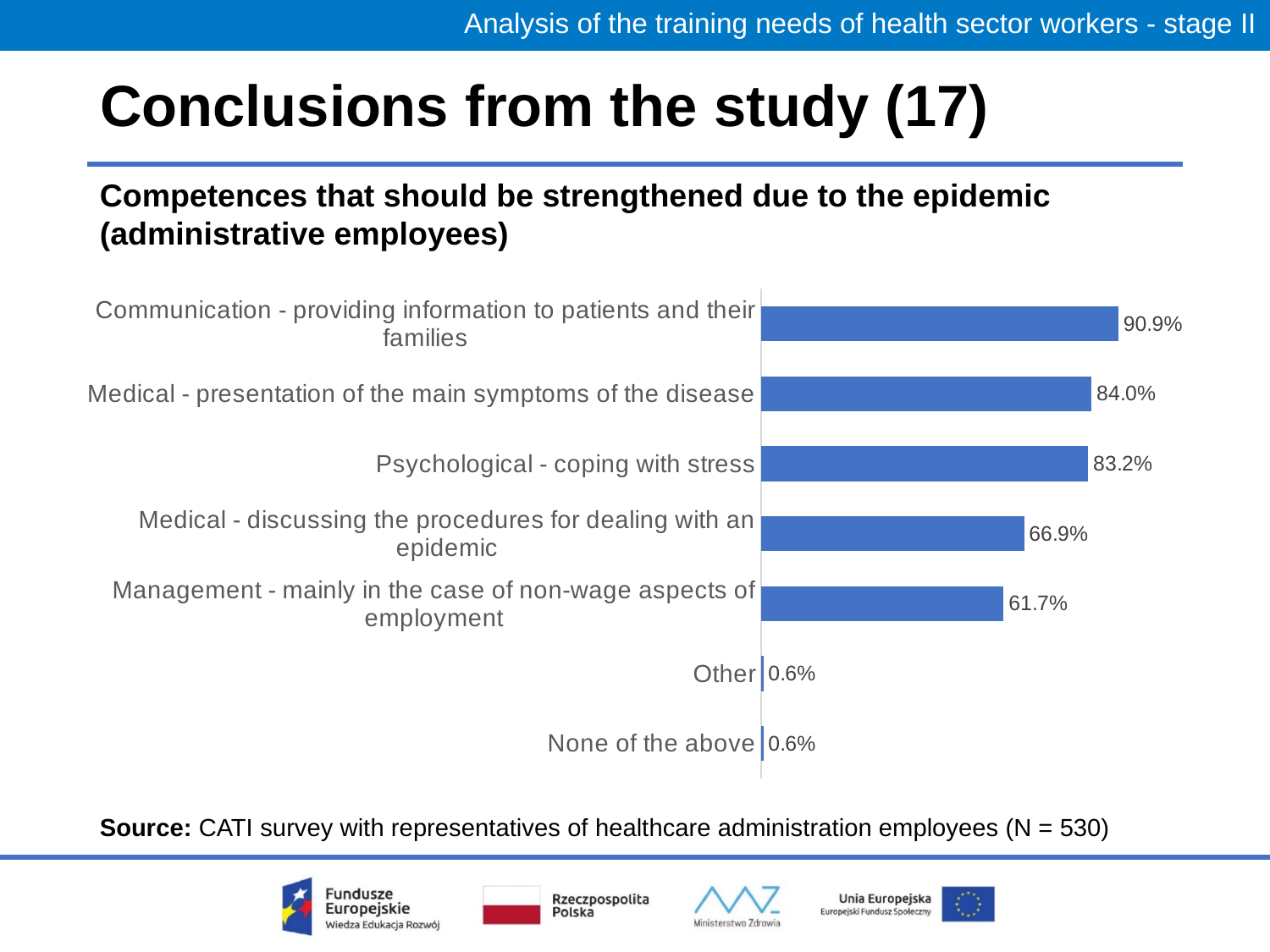
What is the value for 'Psychological - coping with stress'? 83.2% What is the sample size (N) stated in the source note below the chart? 530 How many categories are shown in the chart? 7 What is the value for 'None of the above'? 0.6% What is the difference between 'Medical - presentation of the main symptoms of the disease' and 'Psychological - coping with stress'? 0.8% What is the value for 'Medical - discussing the procedures for dealing with an epidemic'? 66.9% Which category has the highest value? Communication - providing information to patients and their families What is the difference between 'Communication - providing information to patients and their families' and 'Management - mainly in the case of non-wage aspects of employment'? 29.2% What percentage is shown for 'Management - mainly in the case of non-wage aspects of employment'? 61.7% Which is larger: 'Medical - discussing the procedures for dealing with an epidemic' or 'Management - mainly in the case of non-wage aspects of employment'? Medical - discussing the procedures for dealing with an epidemic What kind of chart is shown on the slide? Bar chart What percentage is shown for 'Communication - providing information to patients and their families'? 90.9%